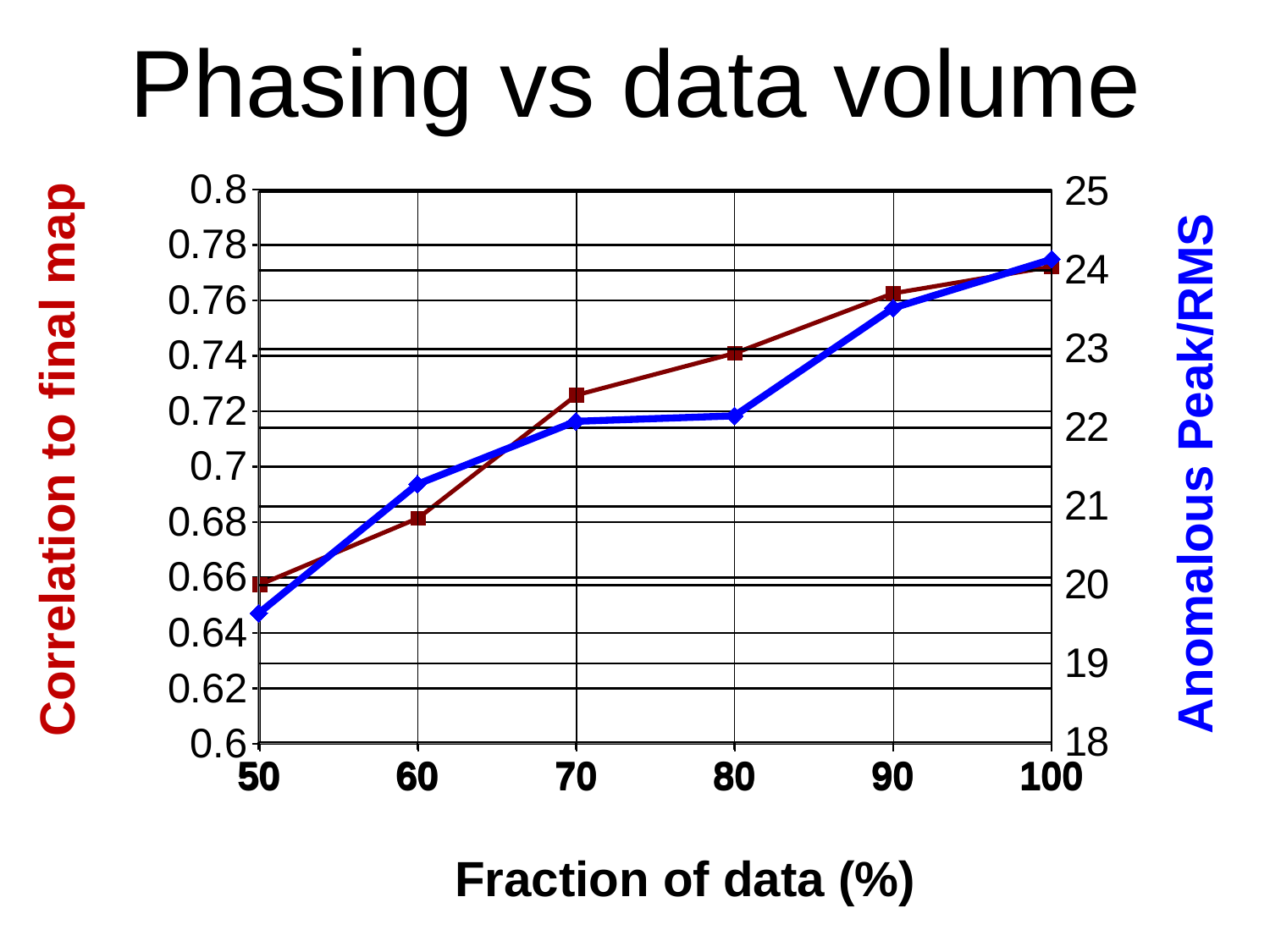
What is the title of the x axis? Fraction of data (%) Which series is plotted against the right-hand axis? Anomalous Peak/RMS How many data points are plotted along the x axis for each series? 6 Is the Correlation to final map at 50% of the data greater or less than 0.68? less Does the Correlation to final map rise or fall as the fraction of data increases from 50 to 100? rises What kind of chart is shown on the slide? line chart Is the Anomalous Peak/RMS at 90% of the data greater or less than 23? greater At which fraction of data is the Anomalous Peak/RMS lowest? 50 Is the Correlation to final map at 80% of the data greater or less than 0.72? greater Does the Anomalous Peak/RMS rise or fall as the fraction of data increases from 50 to 100? rises At which fraction of data is the Correlation to final map highest? 100